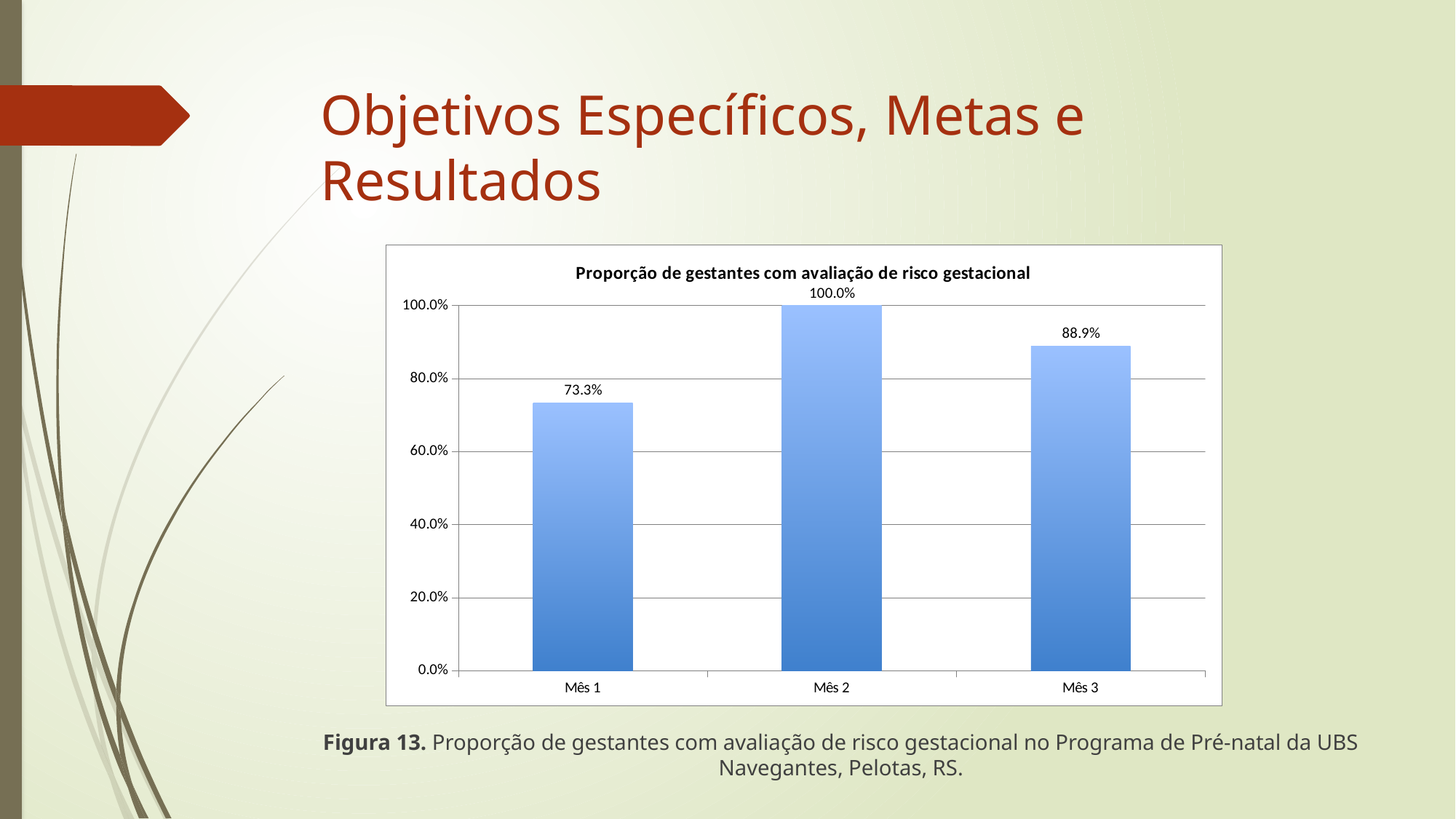
What is the difference between the values for Mês 3 and Mês 1? 15.6% Which month has the lowest proportion? Mês 1 What is the title of the chart? Proporção de gestantes com avaliação de risco gestacional What is the value for Mês 2? 100.0% What is the value for Mês 3? 88.9% What kind of chart is shown on the slide? bar chart What is the value for Mês 1? 73.3% What is the difference between the values for Mês 2 and Mês 1? 26.7% Is the value for Mês 1 greater or less than 80.0%? less How many categories are shown on the x axis? 3 Which month has the highest proportion? Mês 2 Which is larger, the value for Mês 3 or the value for Mês 1? Mês 3